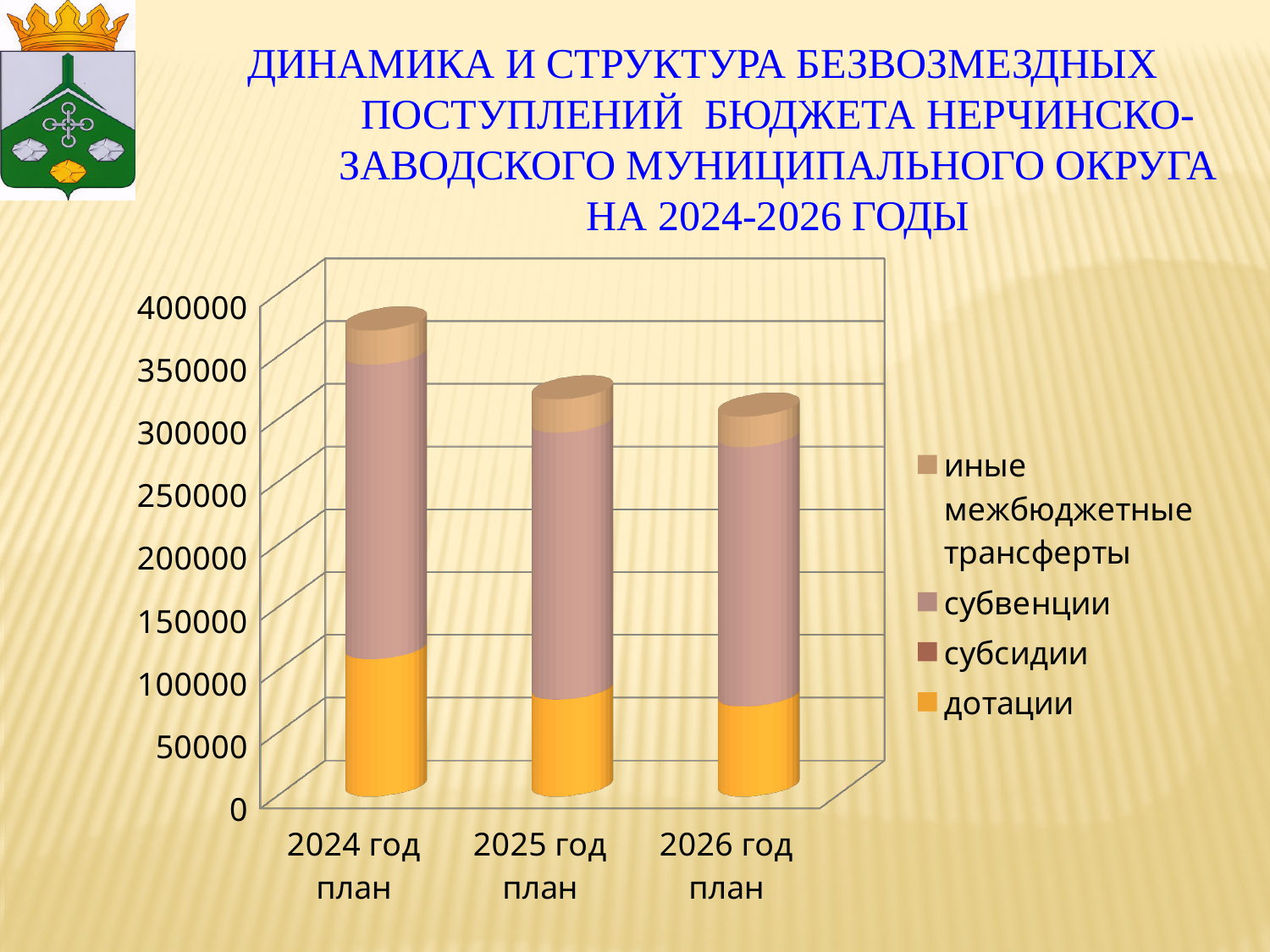
Is the total height of the bar for 2026 год план greater or less than 350000? less Do the total heights of the stacked bars rise or fall from 2024 to 2026? Fall Is the total height of the bar for 2024 год план greater or less than 300000? greater What kind of chart is shown on the slide? Stacked bar chart Which stacked bar is taller: 2024 год план or 2025 год план? 2024 год план How many categories (years) are shown on the x axis of the chart? 3 Which year has the shortest stacked bar in the chart? 2026 год план Which series is shown in orange at the bottom of each bar? дотации Which legend entry is listed first (at the top) in the chart legend? иные межбюджетные трансферты How many series does the chart legend list? 4 Is the дотации segment for 2025 год план greater or less than 100000? less Which year has the tallest stacked bar in the chart? 2024 год план